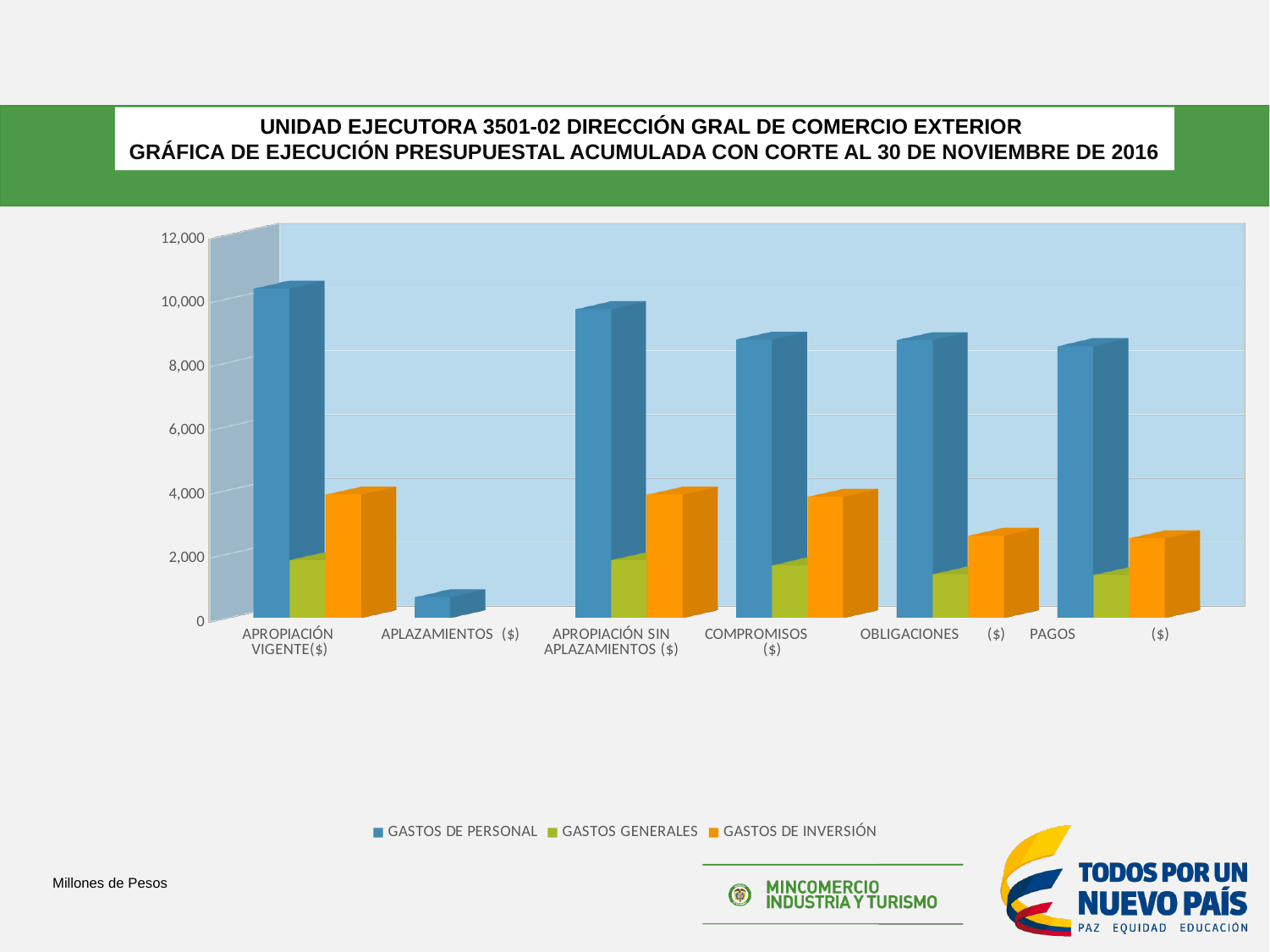
How many series does the chart legend list? 3 For PAGOS ($), which is larger: GASTOS GENERALES or GASTOS DE INVERSIÓN? GASTOS DE INVERSIÓN Is the GASTOS DE PERSONAL value for APLAZAMIENTOS ($) greater or less than 2,000? less Which category has the highest value for GASTOS DE PERSONAL? APROPIACIÓN VIGENTE($) Which series is shown in orange in the chart legend? GASTOS DE INVERSIÓN Which category has the lowest value for GASTOS DE PERSONAL? APLAZAMIENTOS ($) Is the GASTOS DE INVERSIÓN value for COMPROMISOS ($) greater or less than 6,000? less For APROPIACIÓN VIGENTE($), which is larger: GASTOS DE PERSONAL or GASTOS DE INVERSIÓN? GASTOS DE PERSONAL How many categories are shown along the x axis of the chart? 6 What kind of chart is shown on the slide? bar chart Is the GASTOS DE PERSONAL value for APROPIACIÓN VIGENTE($) greater or less than 8,000? greater